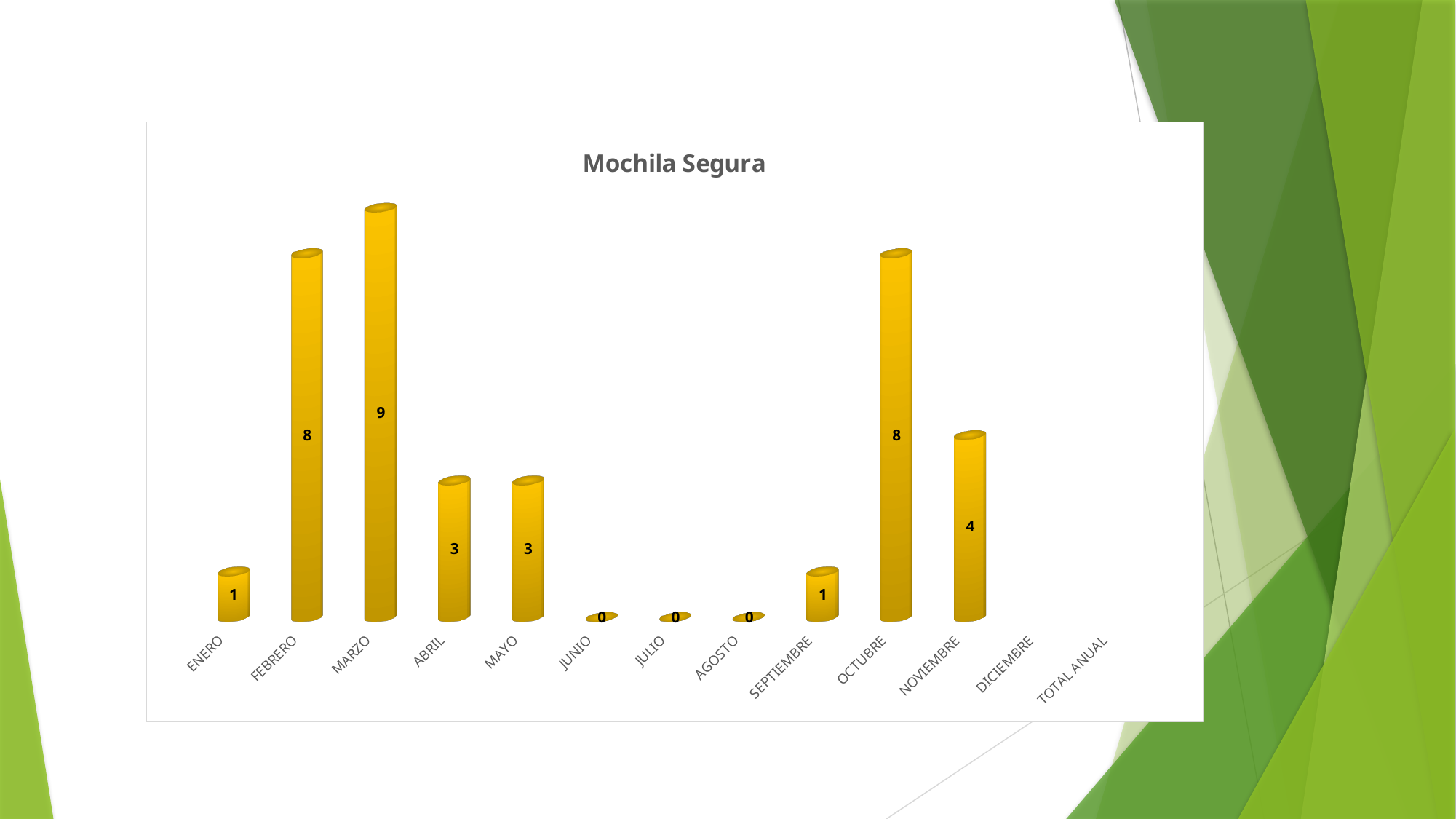
What kind of chart is shown? bar chart What is the difference between the values for MARZO and FEBRERO? 1 How many categories are labelled on the x axis? 13 What is the difference between the values for OCTUBRE and NOVIEMBRE? 4 What is the value for SEPTIEMBRE? 1 What is the title of the chart? Mochila Segura Which is larger, the value for ABRIL or the value for ENERO? ABRIL Which category has the highest value? MARZO What is the value for JULIO? 0 What is the value for NOVIEMBRE? 4 What is the value for MARZO? 9 Which is larger, the value for FEBRERO or the value for NOVIEMBRE? FEBRERO